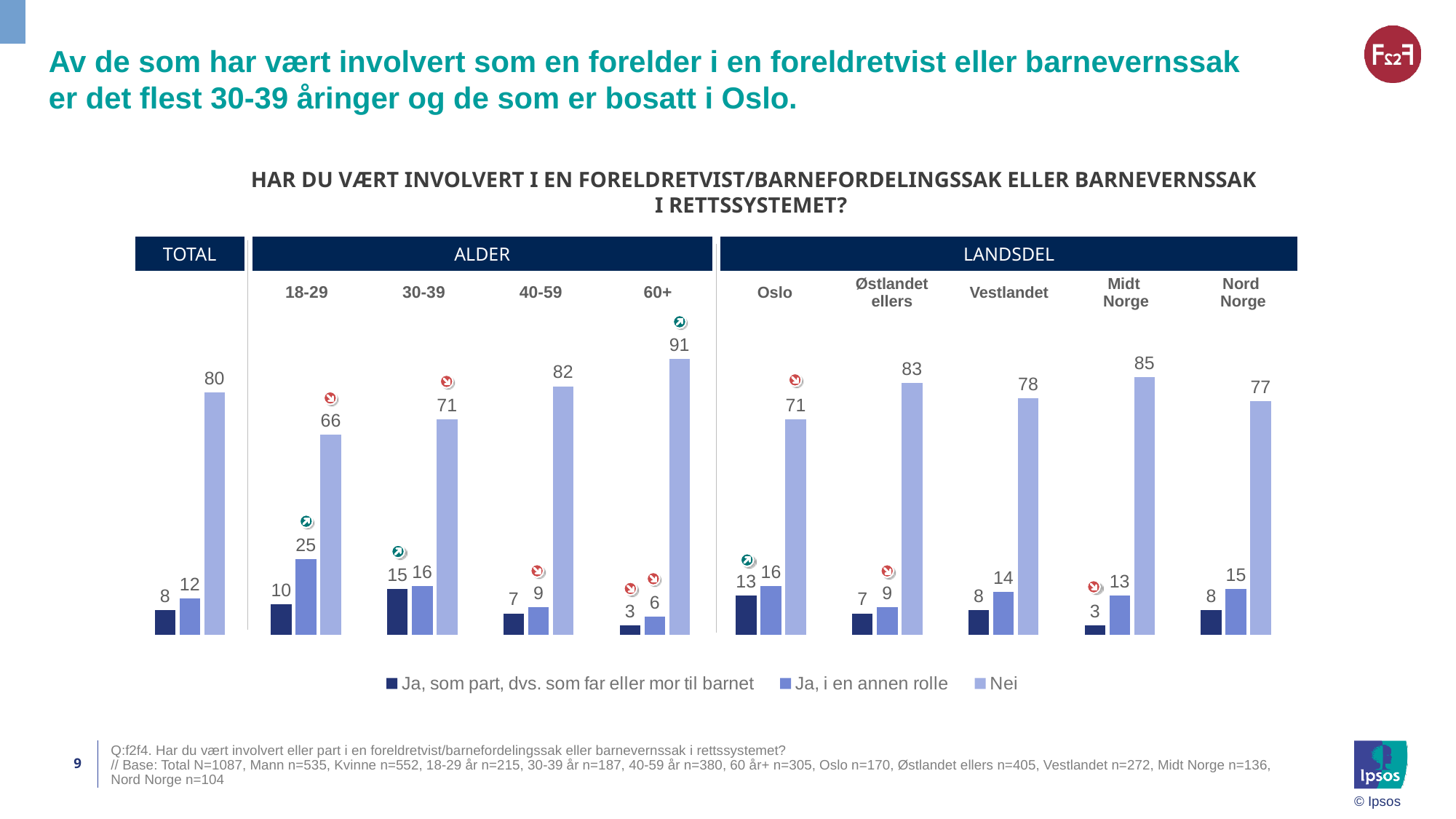
Which age group has the lowest value for "Ja, som part, dvs. som far eller mor til barnet"? 60+ What is the value of "Ja, som part, dvs. som far eller mor til barnet" for Midt Norge? 3 What is the value of "Ja, som part, dvs. som far eller mor til barnet" for the 30-39 age group? 15 Across the age groups from 18-29 to 60+, does the "Nei" value rise or fall? Rise What is the value of "Nei" for the Total group? 80 What is the difference between the "Nei" values for Midt Norge and Nord Norge? 8 Which is larger: the "Ja, i en annen rolle" value for Vestlandet or for Oslo? Oslo Which group has the highest value for "Nei"? 60+ How many series does the legend list? 3 How many groups (categories) are plotted on the chart? 10 What kind of chart is shown on the slide? Bar chart What is the value of "Ja, i en annen rolle" for the 18-29 age group? 25